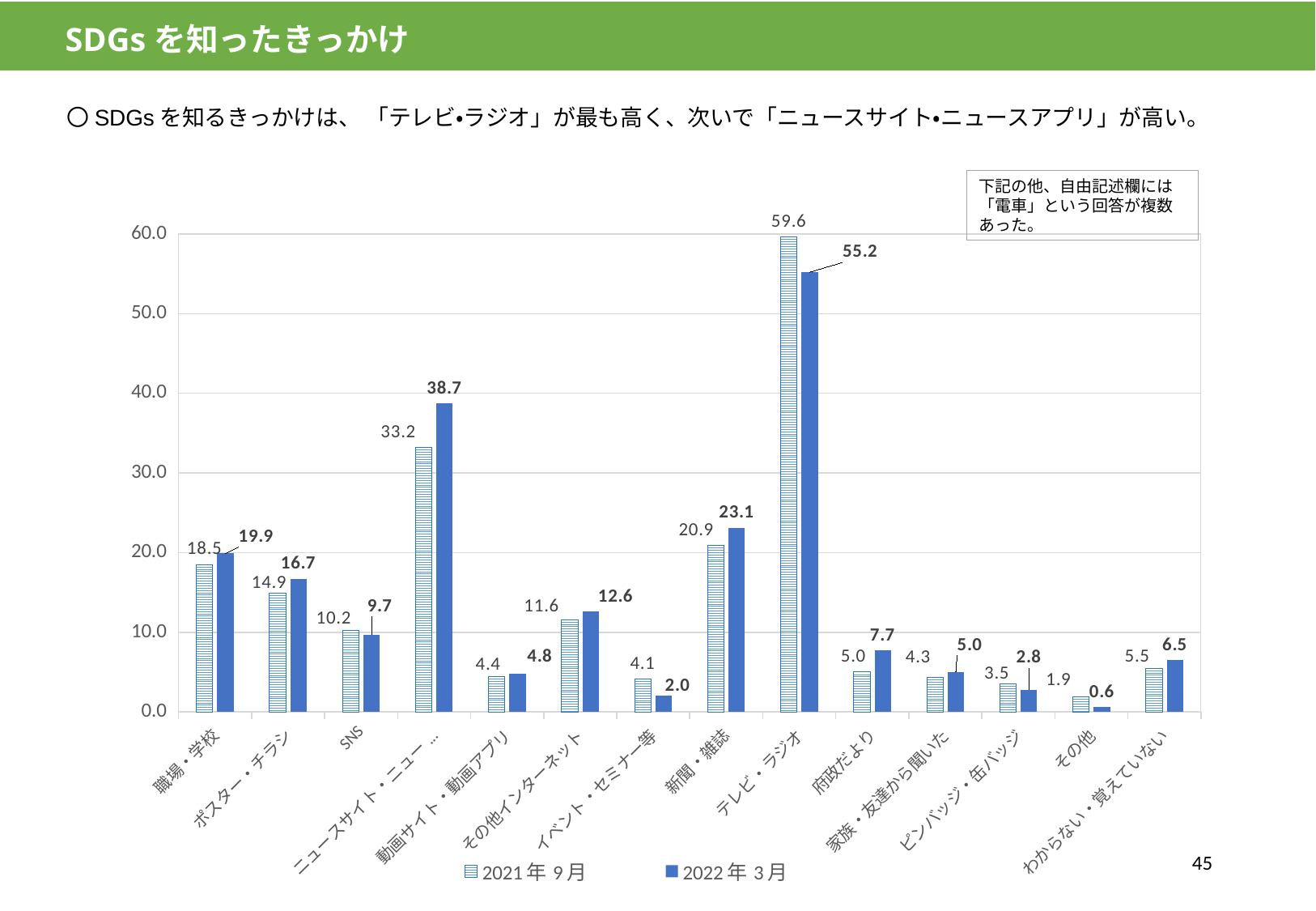
What is the difference between the 2021年9月 and 2022年3月 values for テレビ・ラジオ? 4.4 What kind of chart is shown on the slide? bar chart Is the 2022年3月 value for 新聞・雑誌 greater or less than 20.0? greater Which is larger for SNS: the 2021年9月 value or the 2022年3月 value? 2021年9月 Which category has the lowest value in the 2022年3月 series? その他 How many series does the legend list? 2 What is the value for テレビ・ラジオ in the 2022年3月 series? 55.2 What are the two series named in the legend? 2021年9月 and 2022年3月 Which category has the highest value in the 2021年9月 series? テレビ・ラジオ What is the value for 府政だより in the 2022年3月 series? 7.7 What is the value for 新聞・雑誌 in the 2021年9月 series? 20.9 How many categories are shown on the x axis? 14